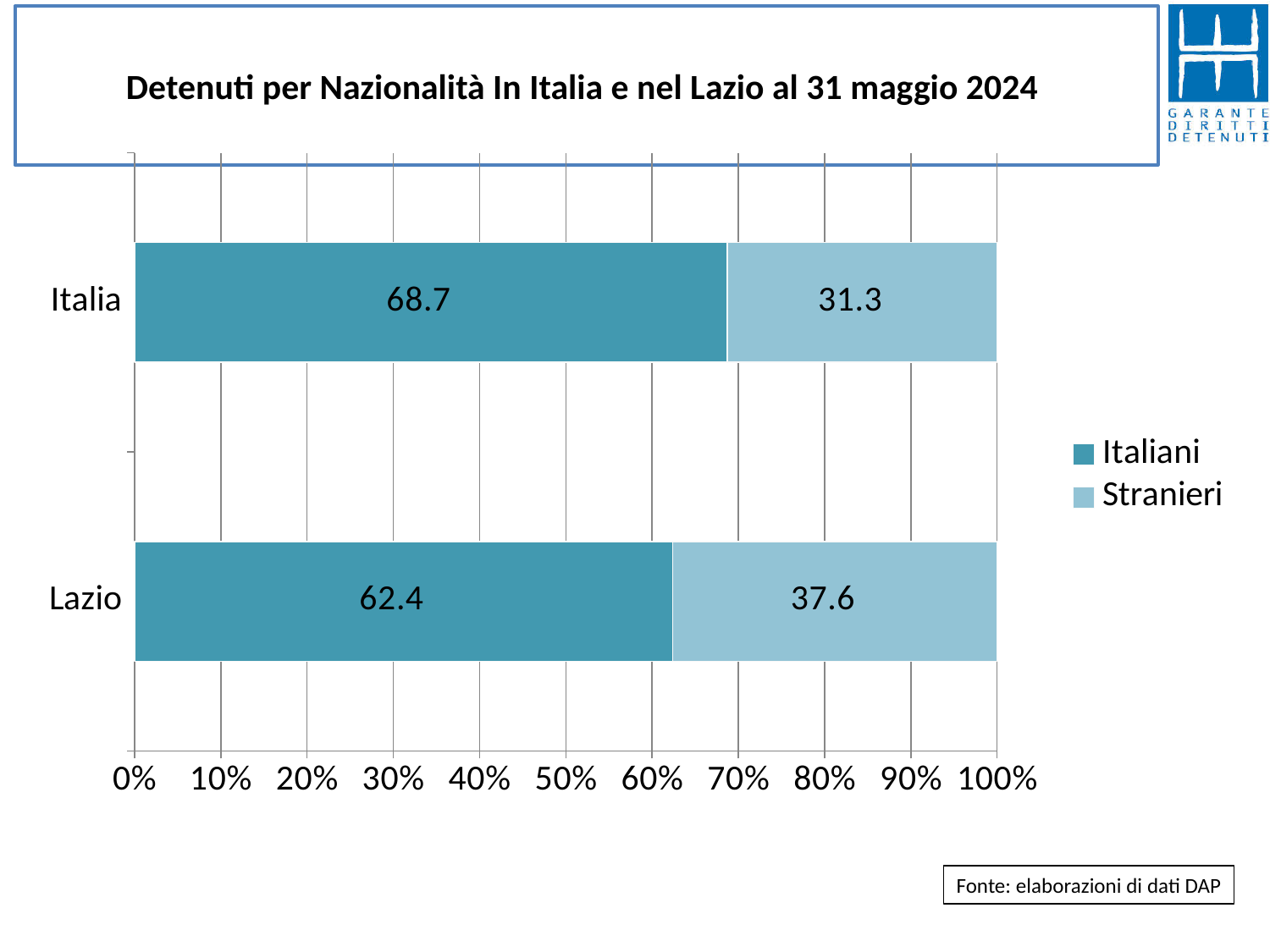
What is the value for Italiani in Lazio? 62.4 What is the difference between the Stranieri values for Lazio and Italia? 6.3 What is the difference between the Italiani values for Italia and Lazio? 6.3 Which category has the higher Stranieri value, Italia or Lazio? Lazio How many series does the legend list? 2 What is the title of the chart? Detenuti per Nazionalità In Italia e nel Lazio al 31 maggio 2024 What is the value for Stranieri in Lazio? 37.6 How many categories are shown on the y axis? 2 Which category has the higher Italiani value, Italia or Lazio? Italia What is the value for Italiani in Italia? 68.7 What kind of chart is shown on the slide? Stacked bar chart What is the value for Stranieri in Italia? 31.3